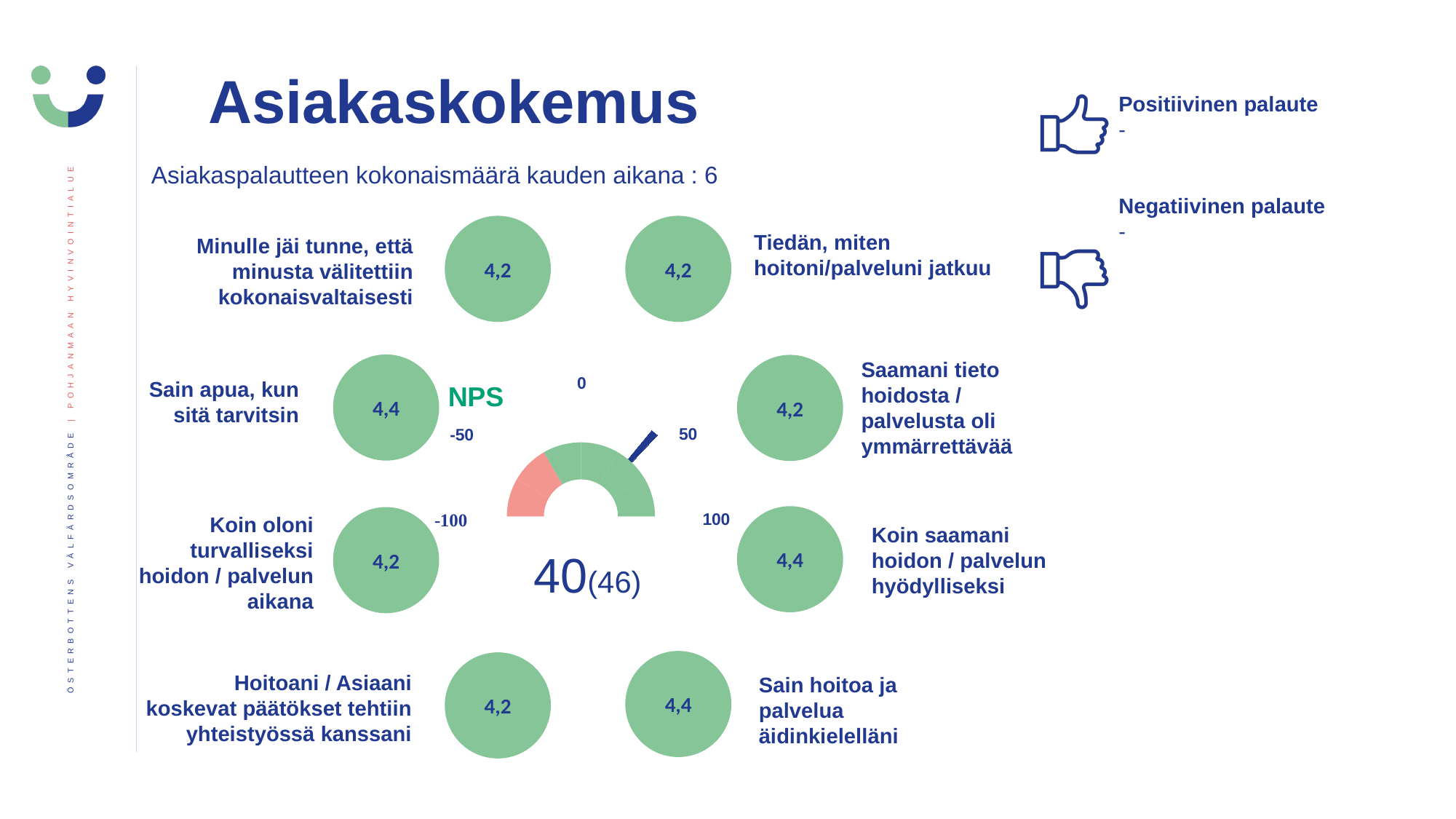
What score is shown in the circle for 'Sain apua, kun sitä tarvitsin'? 4,4 What score is shown in the circle for 'Tiedän, miten hoitoni/palveluni jatkuu'? 4,2 What is the minimum value shown on the NPS gauge scale? -100 What is the maximum value shown on the NPS gauge scale? 100 What value is shown in parentheses next to the NPS value of 40? 46 How many score circles are shown on the slide? 8 What kind of chart is shown in the centre of the slide under the NPS label? gauge chart Is the NPS value indicated by the gauge needle greater or less than 0? greater Which is larger: the score for 'Koin saamani hoidon / palvelun hyödylliseksi' or the score for 'Koin oloni turvalliseksi hoidon / palvelun aikana'? Koin saamani hoidon / palvelun hyödylliseksi What NPS value does the gauge chart show? 40 What is the difference between the score for 'Sain apua, kun sitä tarvitsin' and the score for 'Saamani tieto hoidosta / palvelusta oli ymmärrettävää'? 0,2 What score is shown in the circle for 'Sain hoitoa ja palvelua äidinkielelläni'? 4,4